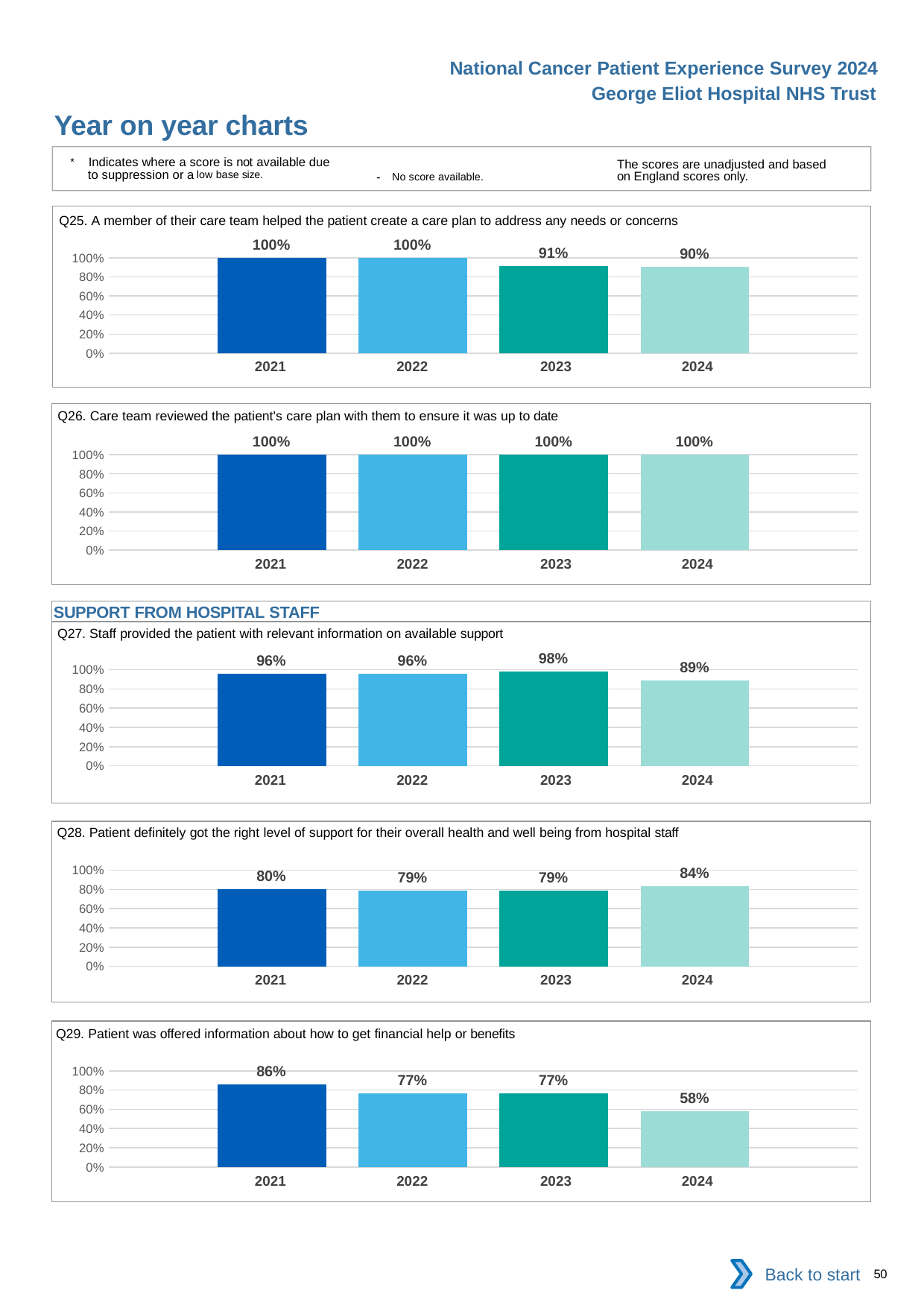
What type of chart is used for Q28? bar chart In the Q29 chart, do the values rise or fall from 2021 to 2024? fall How many years are shown in the Q25 chart? 4 In the Q27 chart, which year has the highest value? 2023 In the Q27 chart, what is the difference between the 2023 and 2024 values? 9 percentage points In the Q29 chart, what is the difference between the 2021 and 2024 values? 28 percentage points In the Q25 chart, which year has the lowest value? 2024 In the Q28 chart, which is larger, the value for 2024 or the value for 2022? 2024 In the Q28 chart, what is the value for 2021? 80% In the Q26 chart, what is the value for 2024? 100% In the Q29 chart, what is the value for 2024? 58% In the Q25 chart, what is the value for 2023? 91%